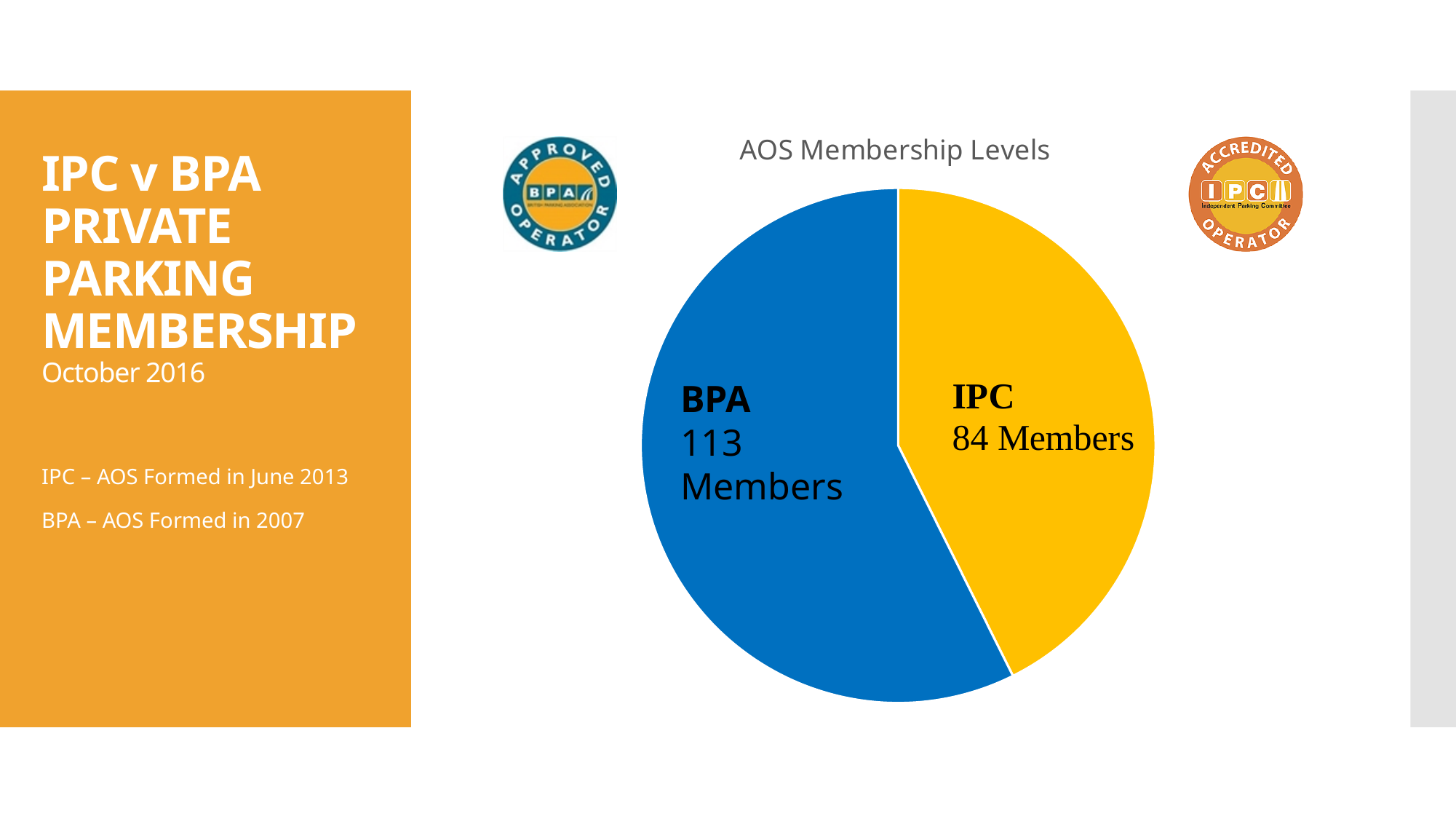
Which has more members, IPC or BPA? BPA Which organisation has the larger slice of the pie? BPA What colour is the BPA slice of the pie? blue How many members does IPC have according to the chart? 84 Members What type of chart is shown on the slide? pie chart What is the title of the chart? AOS Membership Levels Which organisation has the smaller slice of the pie? IPC How many slices does the pie chart have? 2 How many members does BPA have according to the chart? 113 Members How many more members does BPA have than IPC? 29 What is the total number of members shown across both slices? 197